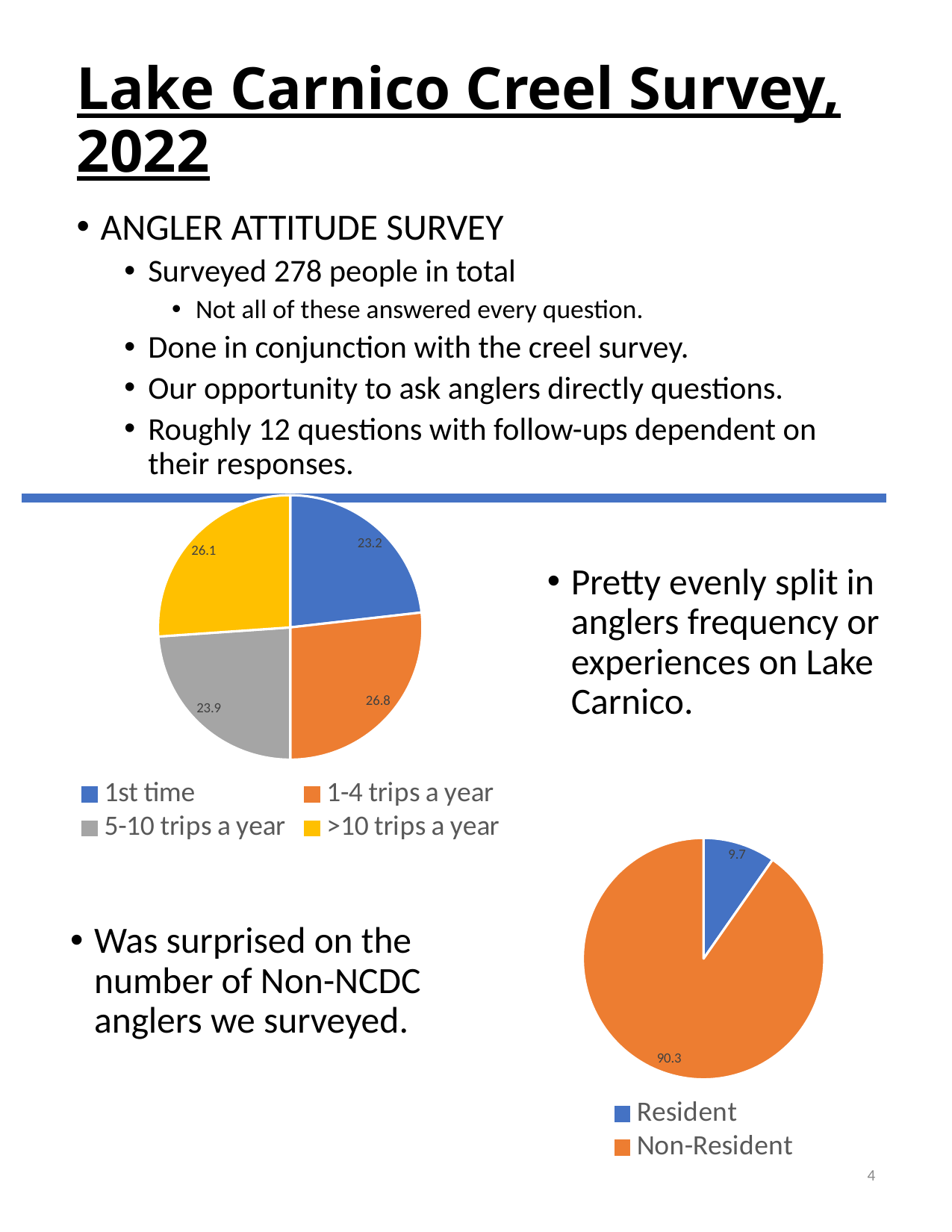
In the pie chart at the bottom right of the slide, what value is shown for 'Resident'? 9.7 In the pie chart on the left of the slide, which category has the smallest slice? 1st time In the pie chart on the left of the slide, how many categories does the legend list? 4 What type of chart is used at the bottom right of the slide to show Resident versus Non-Resident anglers? Pie chart In the pie chart on the left of the slide, what value is shown for '1-4 trips a year'? 26.8 In the pie chart on the left of the slide, which category has the largest slice? 1-4 trips a year In the pie chart on the left of the slide, what value is shown for the '1st time' slice? 23.2 In the pie chart on the left of the slide, what value is shown for '5-10 trips a year'? 23.9 In the pie chart at the bottom right of the slide, which is larger, the 'Resident' slice or the 'Non-Resident' slice? Non-Resident In the pie chart on the left of the slide, what is the difference between the '1-4 trips a year' value and the '1st time' value? 3.6 In the pie chart on the left of the slide, what value is shown for '>10 trips a year'? 26.1 In the pie chart at the bottom right of the slide, what value is shown for 'Non-Resident'? 90.3